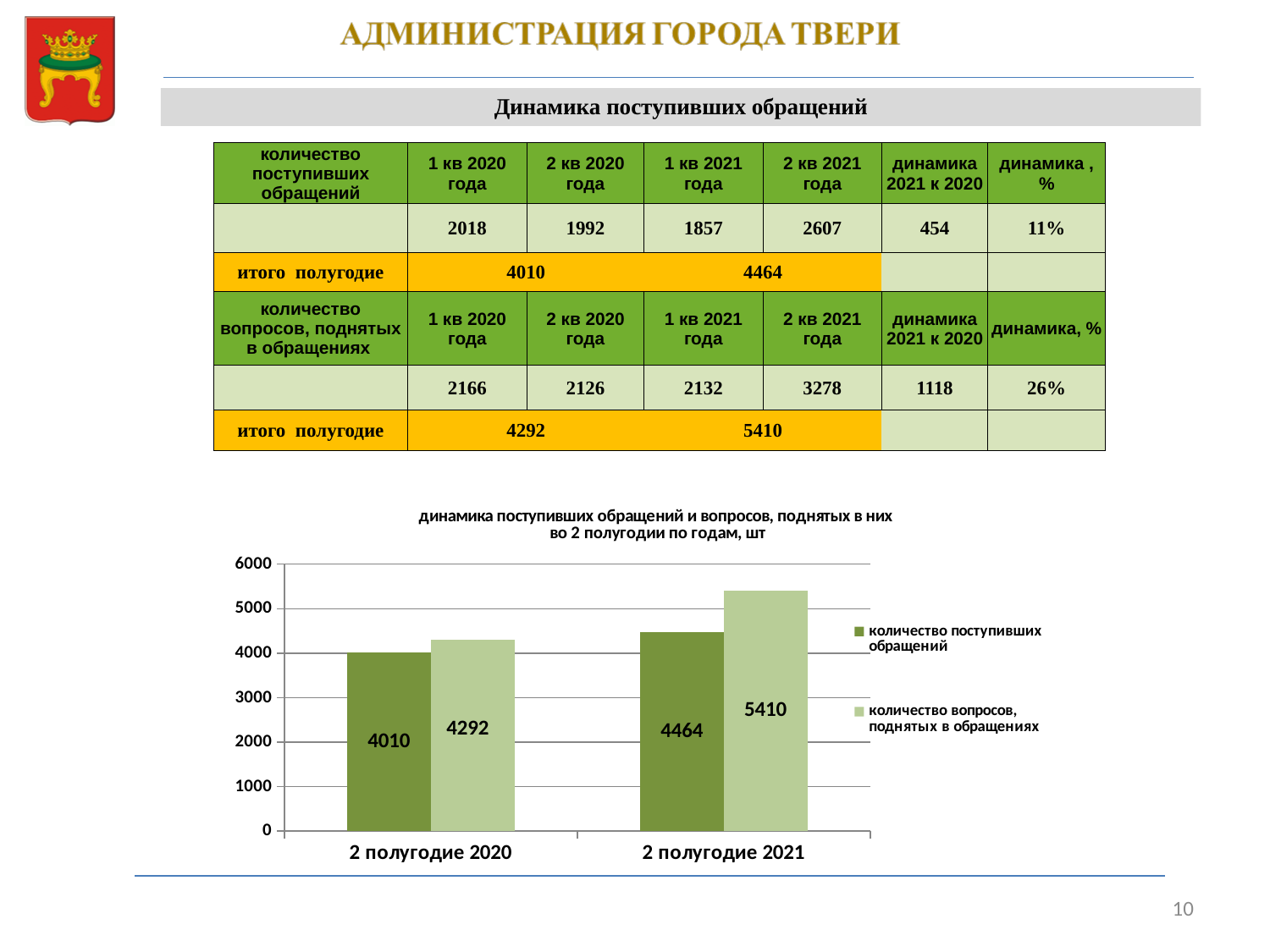
What type of chart is shown on the slide? bar chart What is the value for "количество вопросов, поднятых в обращениях" in "2 полугодие 2021"? 5410 What is the value for "количество поступивших обращений" in "2 полугодие 2021"? 4464 What is the difference between "количество вопросов, поднятых в обращениях" in 2 полугодие 2021 and in 2 полугодие 2020? 1118 Does "количество поступивших обращений" rise or fall from 2 полугодие 2020 to 2 полугодие 2021? rise What is the value for "количество поступивших обращений" in "2 полугодие 2020"? 4010 Which is larger: "количество поступивших обращений" in 2 полугодие 2021 or "количество вопросов, поднятых в обращениях" in 2 полугодие 2020? количество поступивших обращений in 2 полугодие 2021 What is the value for "количество вопросов, поднятых в обращениях" in "2 полугодие 2020"? 4292 Which bar in the chart has the lowest value? количество поступивших обращений, 2 полугодие 2020 Which bar in the chart has the highest value? количество вопросов, поднятых в обращениях, 2 полугодие 2021 What is the difference between "количество поступивших обращений" in 2 полугодие 2021 and in 2 полугодие 2020? 454 How many series does the chart legend list? 2